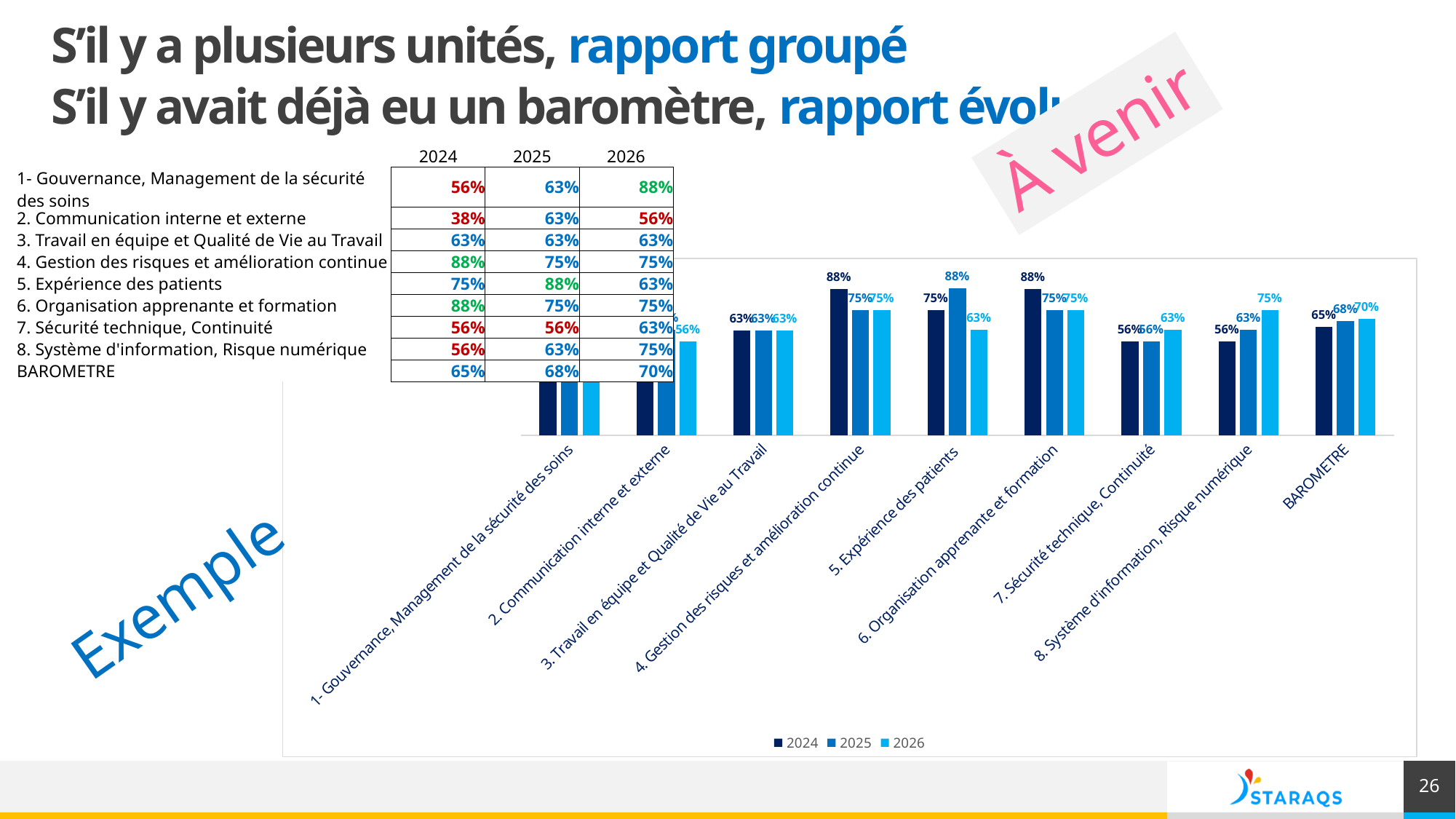
For '5. Expérience des patients', which year has the larger value, 2024 or 2025? 2025 What is the difference between the 2026 and 2024 values for '8. Système d'information, Risque numérique'? 19 percentage points How many series does the chart legend list? 3 What is the 2026 value for '8. Système d'information, Risque numérique'? 75% What kind of chart is shown on the slide? bar chart What is the 2026 value for 'BAROMETRE'? 70% What is the 2025 value for '5. Expérience des patients'? 88% Do the 'BAROMETRE' values rise or fall from 2024 to 2026? rise What is the 2024 value for '7. Sécurité technique, Continuité'? 56% How many categories are shown along the x axis of the chart? 9 Which entries are listed in the chart legend? 2024, 2025, 2026 What is the 2024 value for '4. Gestion des risques et amélioration continue'? 88%